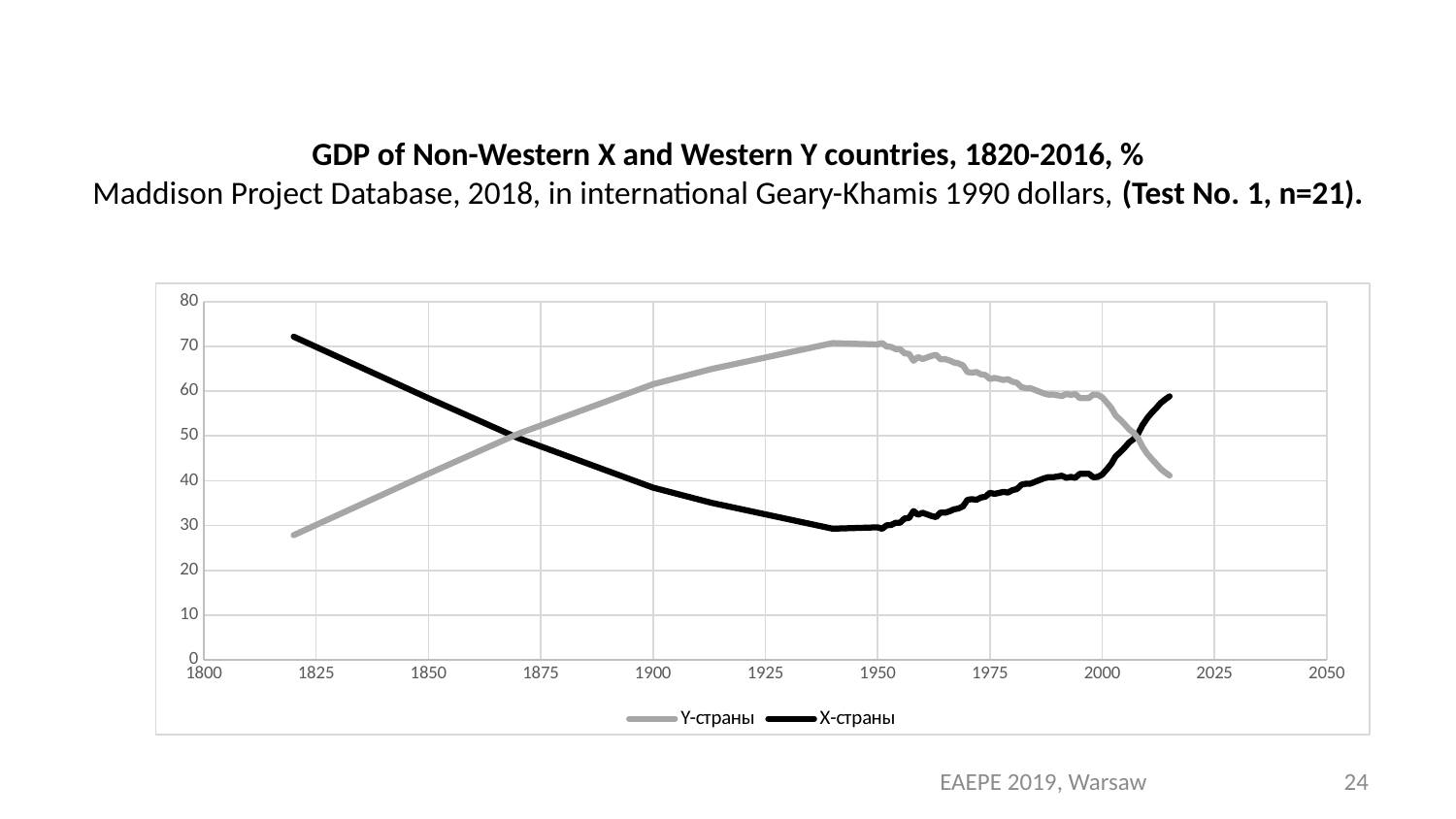
What kind of chart is shown on the slide? line chart Which series is drawn in black? X-страны Which series is drawn in gray? Y-страны Is the value for X-страны in 1940 greater or less than 40? less In 1900, which series has the higher value, Y-страны or X-страны? Y-страны How many series does the legend list? 2 Is the value for Y-страны in 1820 greater or less than 30? less Is the value for X-страны in 2015 greater or less than 50? greater In 1820, which series has the higher value, Y-страны or X-страны? X-страны Does the X-страны line rise or fall between 1820 and 1940? fall